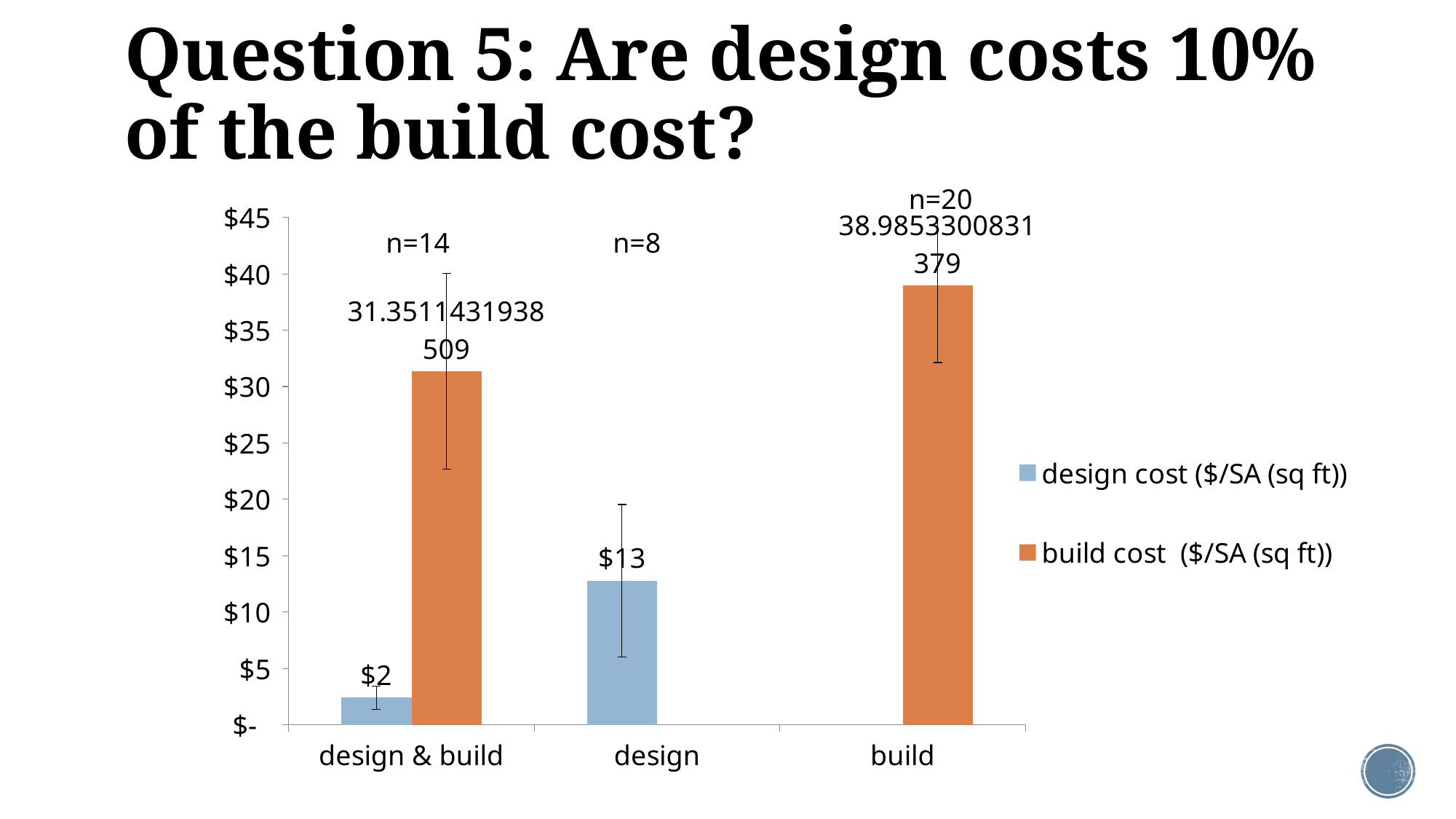
What is the difference between the design cost for the design category and the design cost for the design & build category? $11 Which category has the higher design cost: design & build or design? design What is the build cost ($/SA (sq ft)) for the design & build category, as labelled on the chart? 31.3511431938509 What type of chart is shown on the slide? bar chart How many categories are shown on the x axis? 3 What is the design cost ($/SA (sq ft)) for the design & build category? $2 What is the design cost ($/SA (sq ft)) for the design category? $13 What is the build cost ($/SA (sq ft)) for the build category, as labelled on the chart? 38.9853300831379 What sample size (n) is annotated above the build category? n=20 Is the build cost for the build category greater or less than $35? greater Which category has the higher build cost: design & build or build? build How many series does the legend list? 2